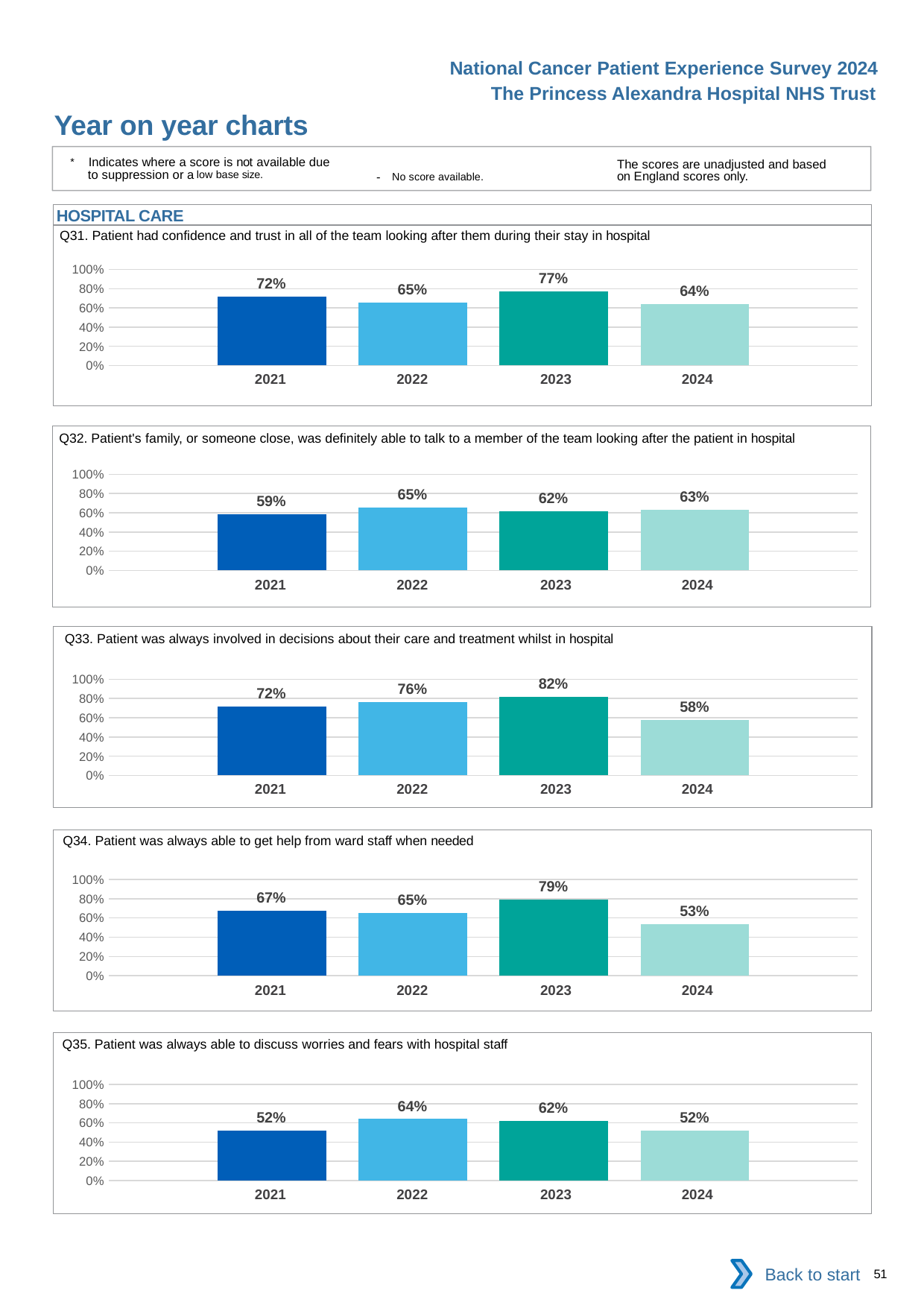
In the Q33 chart, which is larger, the value for 2021 or the value for 2022? 2022 In the Q32 chart, what is the value for 2021? 59% In the Q35 chart, how many years are shown on the x axis? 4 In the Q33 chart, do the values rise or fall from 2021 to 2023? Rise In the Q32 chart, which year has the highest value? 2022 In the Q35 chart, what is the value for 2022? 64% What kind of chart is the Q34 chart? Bar chart In the Q34 chart, is the value for 2023 greater or less than 60%? greater In the Q33 chart, what is the difference between the 2023 and 2024 values? 24% In the Q34 chart, what is the value for 2024? 53% In the Q31 chart, which year has the lowest value? 2024 In the Q31 chart, what is the value for 2023? 77%